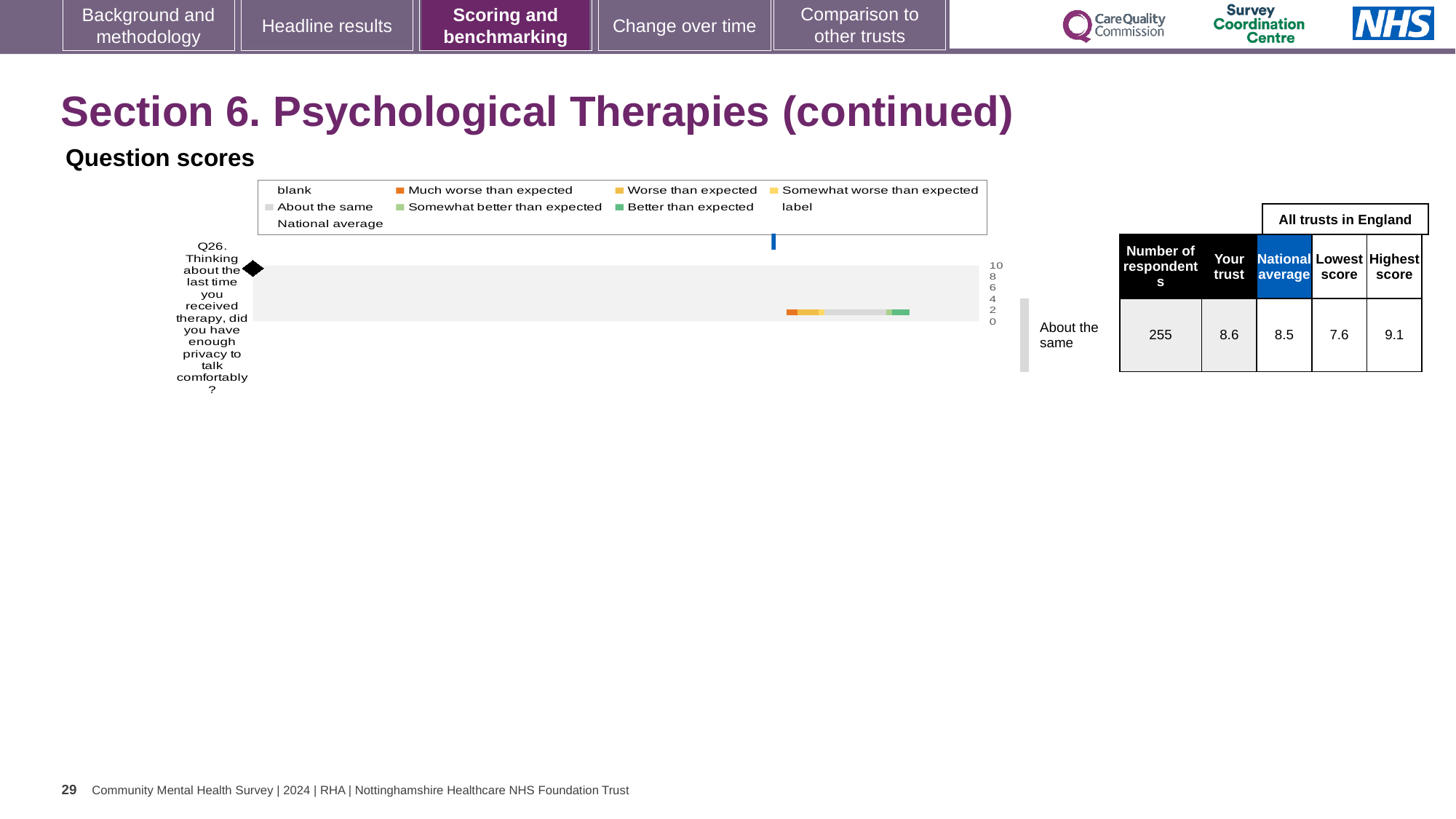
What benchmark rating label is shown next to the Q26 bar in the Question scores chart? About the same For Q26, which is larger: the 'Your trust' score or the National average? Your trust What is the Lowest score among all trusts in England for Q26? 7.6 What is the 'Your trust' score for Q26 in the table beside the chart? 8.6 How many entries does the legend of the Question scores chart list? 9 For Q26, what is the difference between the Highest score and the Lowest score among all trusts in England? 1.5 How many questions (categories) are plotted in the Question scores chart? 1 What is the National average score for Q26 in the table beside the chart? 8.5 What kind of chart is shown under 'Question scores'? bar chart What is the Highest score among all trusts in England for Q26? 9.1 Which question number is plotted in the Question scores chart? Q26 How many respondents answered Q26 according to the table beside the chart? 255